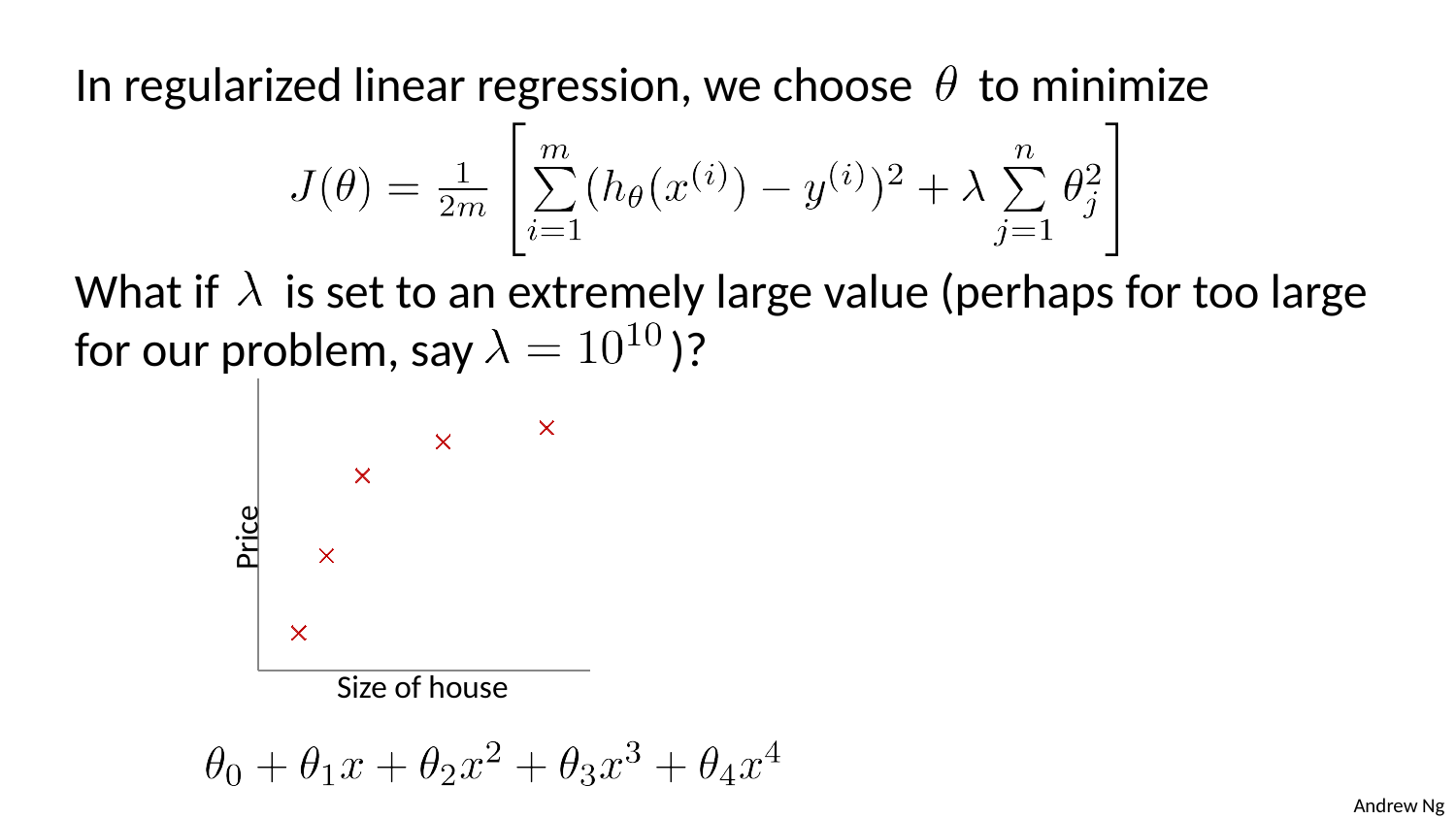
Do the plotted prices rise or fall as the size of house increases along the x axis? rise What is the label of the y axis of the chart? Price What is the label of the x axis of the chart? Size of house What kind of chart is shown on the slide? scatter plot Does the point with the largest size of house have a higher or lower price than the point with the smallest size of house? higher How many data points are plotted on the chart? 5